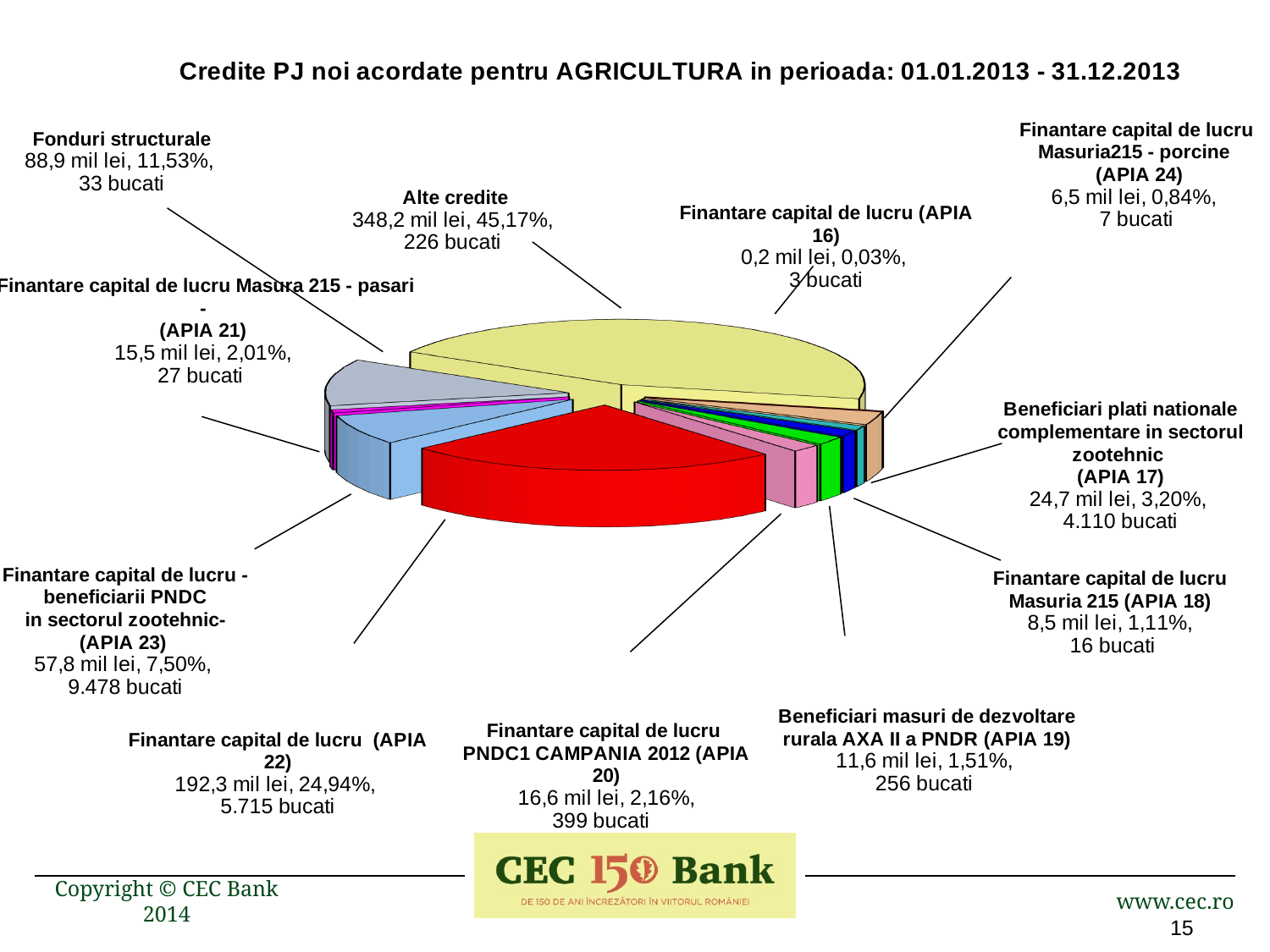
What kind of chart is shown on the slide? pie chart Which category has the smallest share of the pie? Finantare capital de lucru (APIA 16) What is the difference in mil lei between Alte credite and Finantare capital de lucru (APIA 22)? 155,9 mil lei How many categories (slices) does the pie chart show? 11 Which is larger in mil lei: Fonduri structurale or Finantare capital de lucru - beneficiarii PNDC in sectorul zootehnic (APIA 23)? Fonduri structurale What is the value in mil lei for Alte credite? 348,2 mil lei What share of the pie does Finantare capital de lucru (APIA 22) represent? 24,94% Which category has the largest share of the pie? Alte credite What percentage share is shown for Finantare capital de lucru Masuria215 - porcine (APIA 24)? 0,84% What is the title of the chart? Credite PJ noi acordate pentru AGRICULTURA in perioada: 01.01.2013 - 31.12.2013 How many bucati are shown for Finantare capital de lucru PNDC1 CAMPANIA 2012 (APIA 20)? 399 bucati How many bucati are shown for Beneficiari plati nationale complementare in sectorul zootehnic (APIA 17)? 4.110 bucati